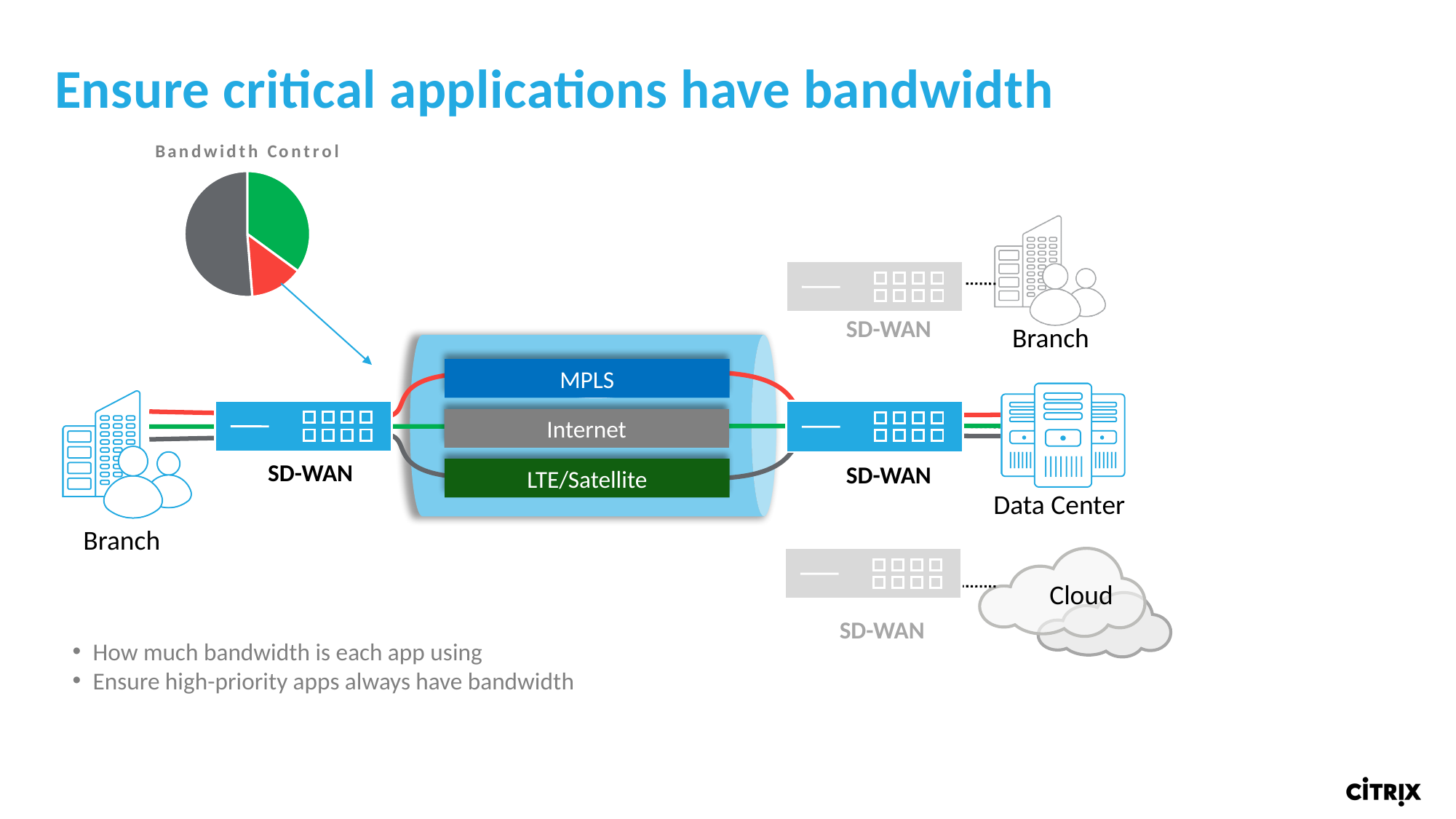
Which colour slice is the largest in the Bandwidth Control pie chart? grey What is the title of the pie chart on the slide? Bandwidth Control What kind of chart is shown under the heading "Bandwidth Control"? pie chart Does the Bandwidth Control pie chart display a legend? No In the Bandwidth Control pie chart, is the green slice larger or smaller than the red slice? larger Which slice of the Bandwidth Control pie chart is pulled out (exploded) from the rest of the pie? the red slice Which colour slice is the smallest in the Bandwidth Control pie chart? red How many slices does the Bandwidth Control pie chart have? 3 In the Bandwidth Control pie chart, is the grey slice larger or smaller than the green slice? larger